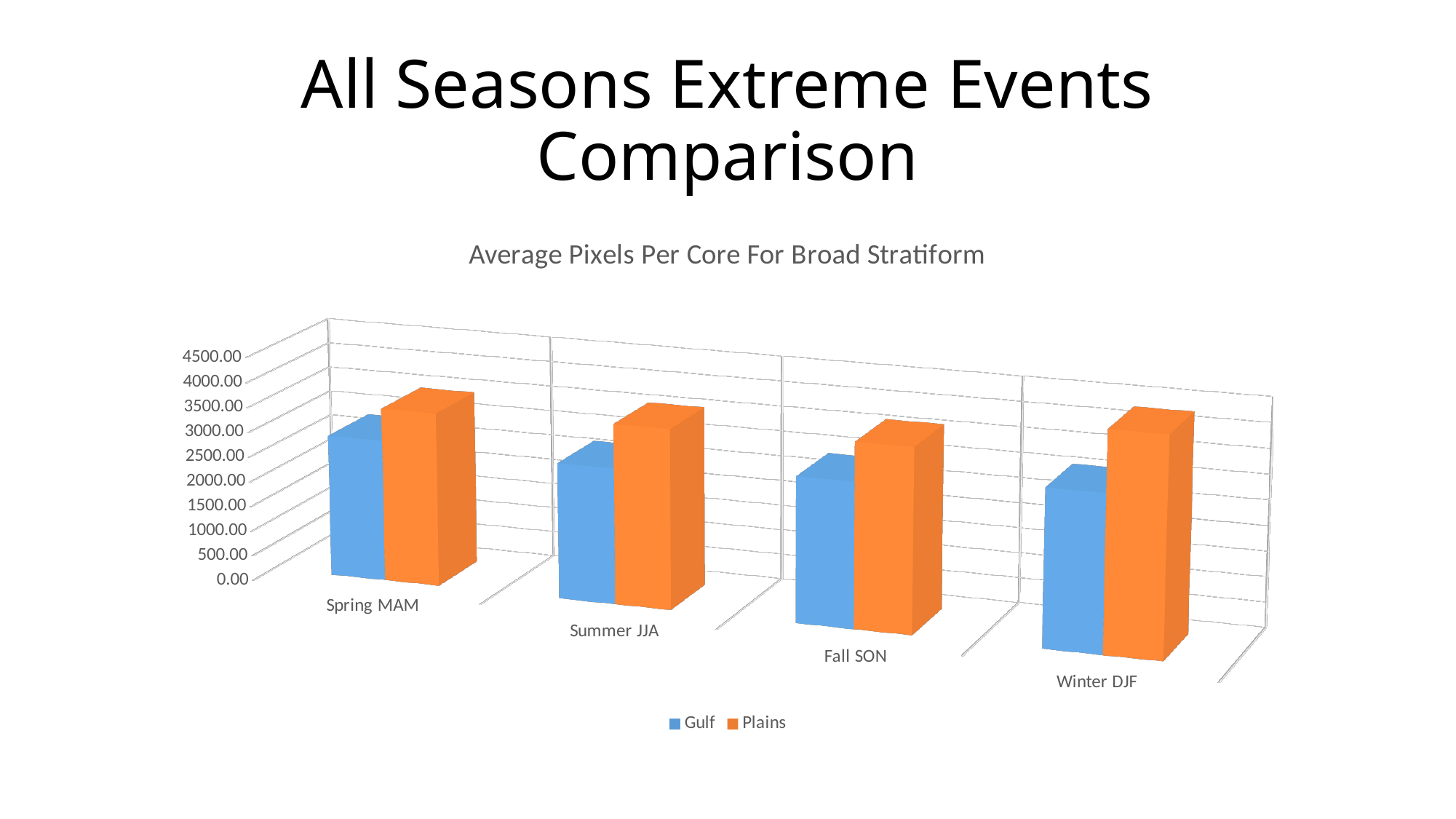
What is the title of the chart? Average Pixels Per Core For Broad Stratiform Which is larger, the Gulf value for Spring MAM or the Gulf value for Winter DJF? Winter DJF How many seasons (categories) are shown on the x axis? 4 In Winter DJF, which series has the larger value, Gulf or Plains? Plains Which series are listed in the legend? Gulf and Plains What kind of chart is shown on the slide? bar chart Is the Plains value for Winter DJF greater or less than 2000? greater How many series does the legend list? 2 Is the Gulf value for Spring MAM greater or less than 1500? greater In Spring MAM, which series has the larger value, Gulf or Plains? Plains